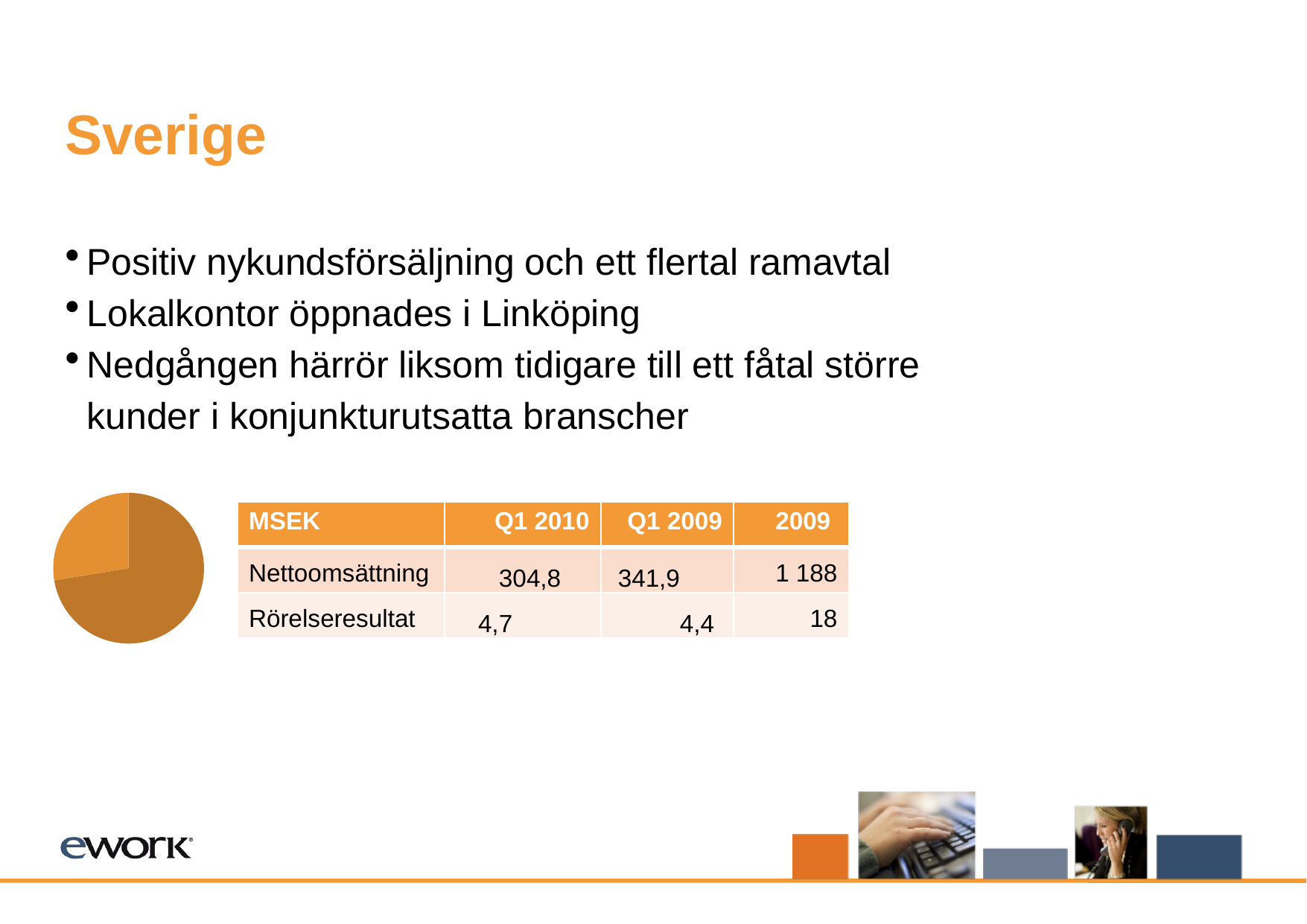
How many slices does the pie chart have? 2 Is the darker orange slice of the pie chart greater or less than half of the pie? greater What kind of chart is shown on the slide? Pie chart Does the pie chart show any data labels on its slices? No Which slice of the pie chart is larger, the lighter orange one or the darker orange one? The darker orange one Does the pie chart display a legend? No